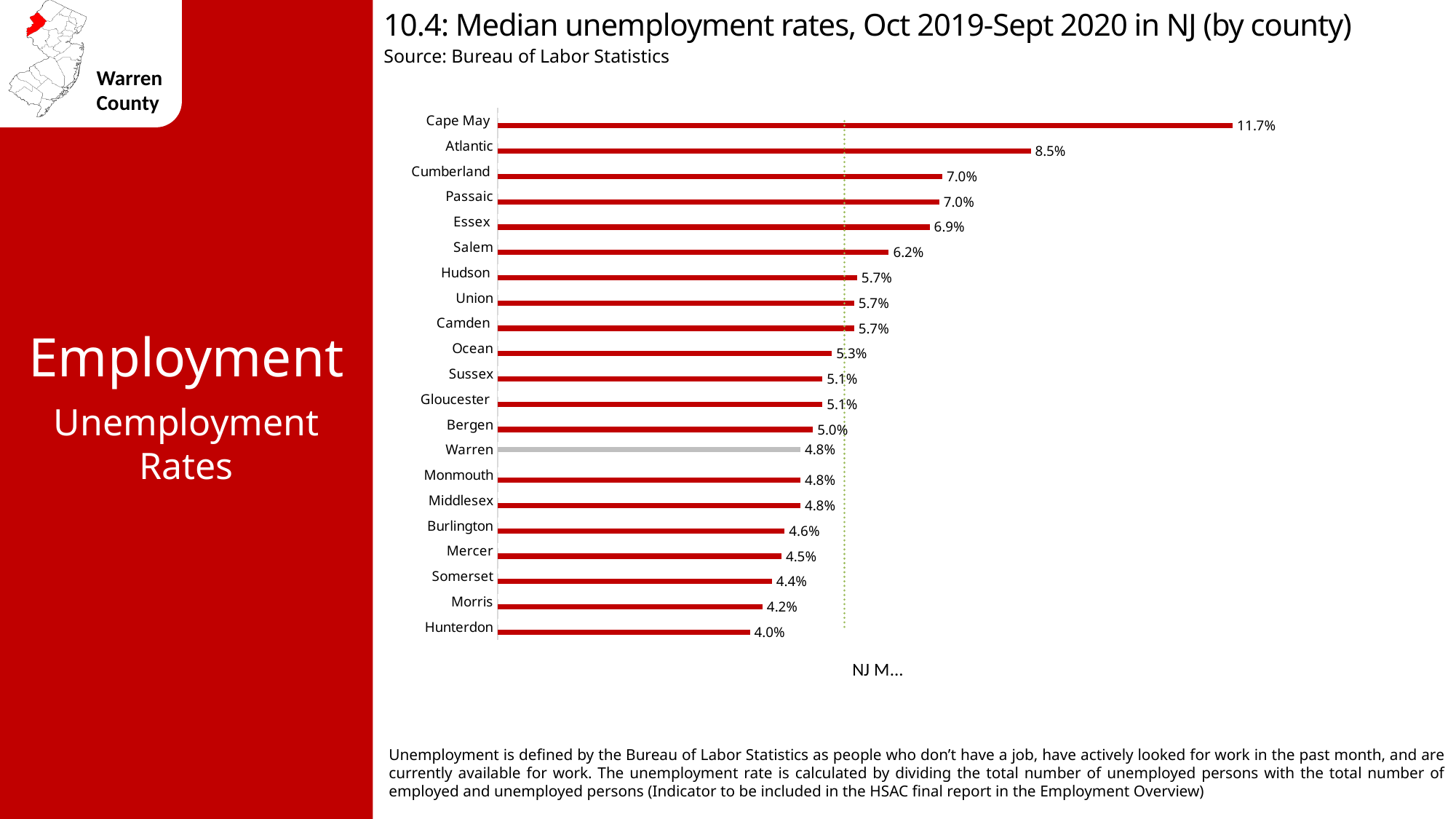
How many counties are shown in the chart? 21 What is the median unemployment rate for Warren County? 4.8% Which county has a higher median unemployment rate, Morris or Somerset? Somerset Which county's bar is shown in grey instead of red? Warren What is the difference between the median unemployment rates of Warren and Hunterdon? 0.8% What is the median unemployment rate for Salem? 6.2% What is the median unemployment rate for Cape May? 11.7% What is the difference between the median unemployment rates of Cape May and Atlantic? 3.2% Which county has the highest median unemployment rate? Cape May Which county has a higher median unemployment rate, Essex or Ocean? Essex What type of chart is used to show the median unemployment rates? Bar chart Which county has the lowest median unemployment rate? Hunterdon